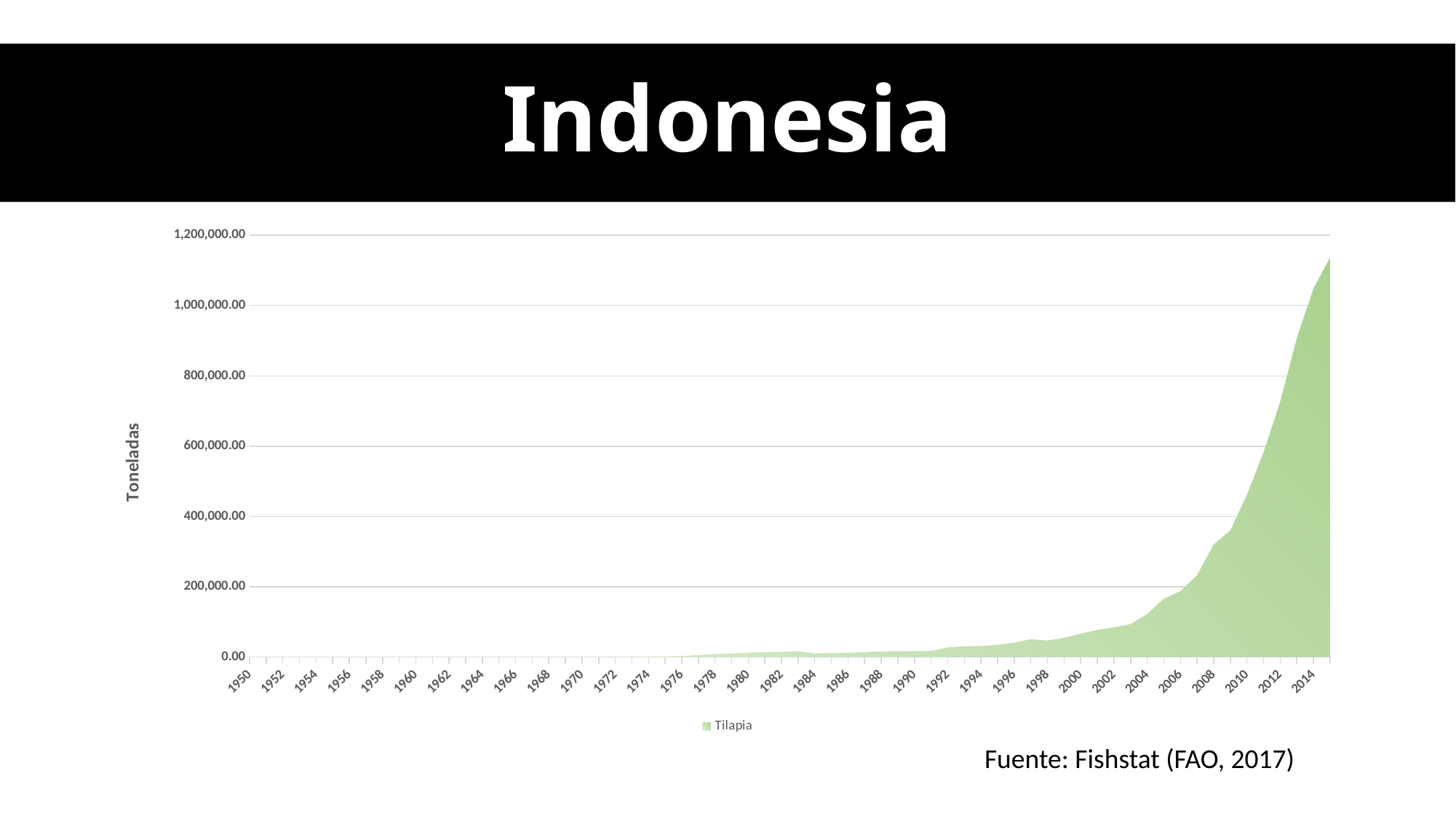
Which year has the larger value, 1980 or 2008? 2008 Is the value for 1990 greater or less than 200,000.00? less What kind of chart is shown on the slide? Area chart Is the value for 2014 greater or less than 800,000.00? greater Do the values generally rise or fall from 1950 to 2014? Rise What is the label of the vertical axis? Toneladas What is the name of the series shown in the legend? Tilapia Is the value for 2010 greater or less than 200,000.00? greater Which year has the larger value, 2000 or 2014? 2014 How many series does the legend list? 1